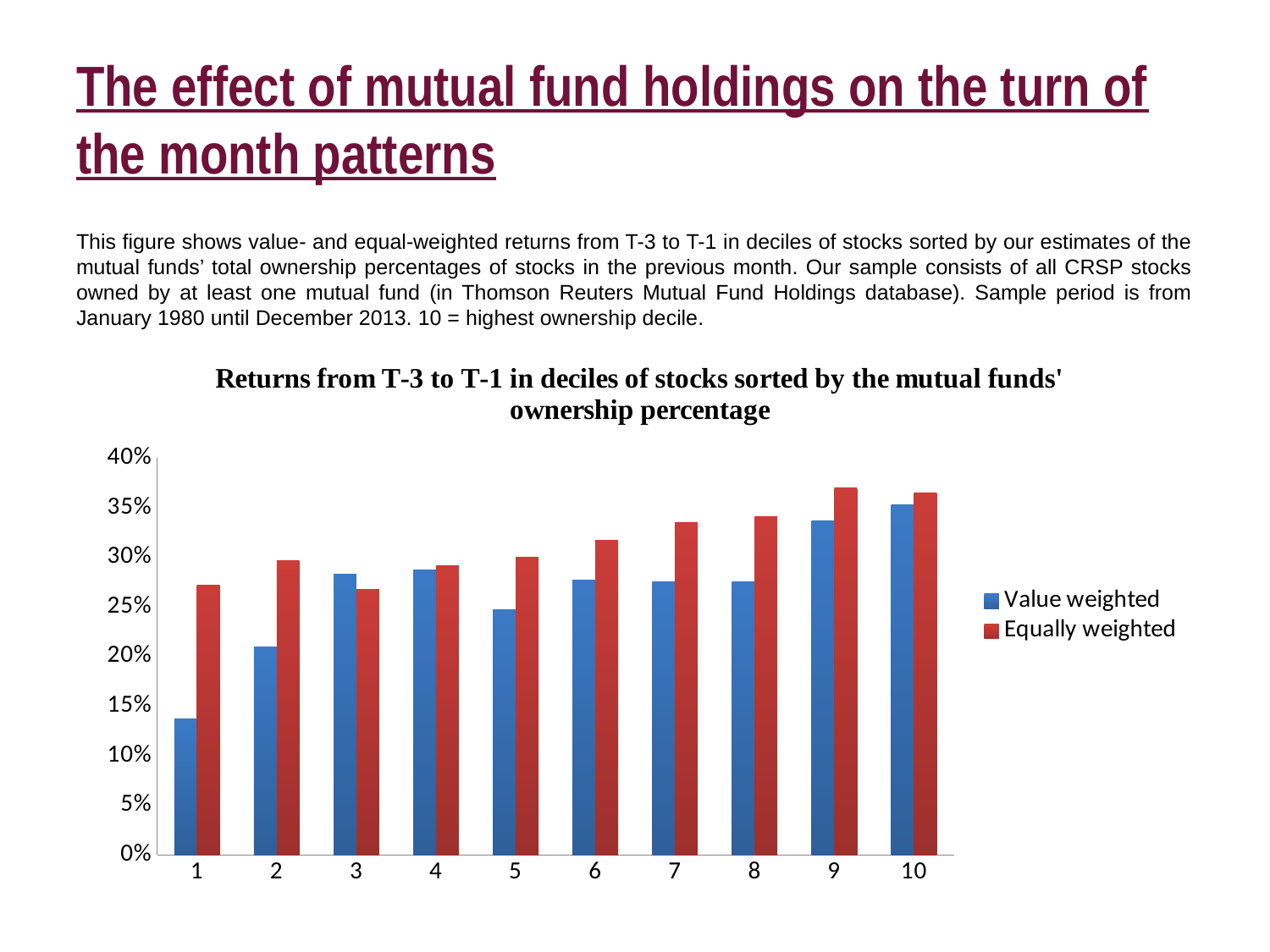
For decile 3, which series has the larger return, Value weighted or Equally weighted? Value weighted For decile 1, which series has the larger return, Value weighted or Equally weighted? Equally weighted How many deciles are shown on the x axis? 10 How many series does the legend list? 2 What kind of chart is shown on the slide? bar chart Is the Value weighted return for decile 1 greater or less than 15%? less Is the Equally weighted return for decile 9 greater or less than 35%? greater Is the Equally weighted return for decile 1 greater or less than 25%? greater Which decile has the highest Value weighted return? 10 Which decile has the lowest Value weighted return? 1 Which colour represents the Equally weighted series? red